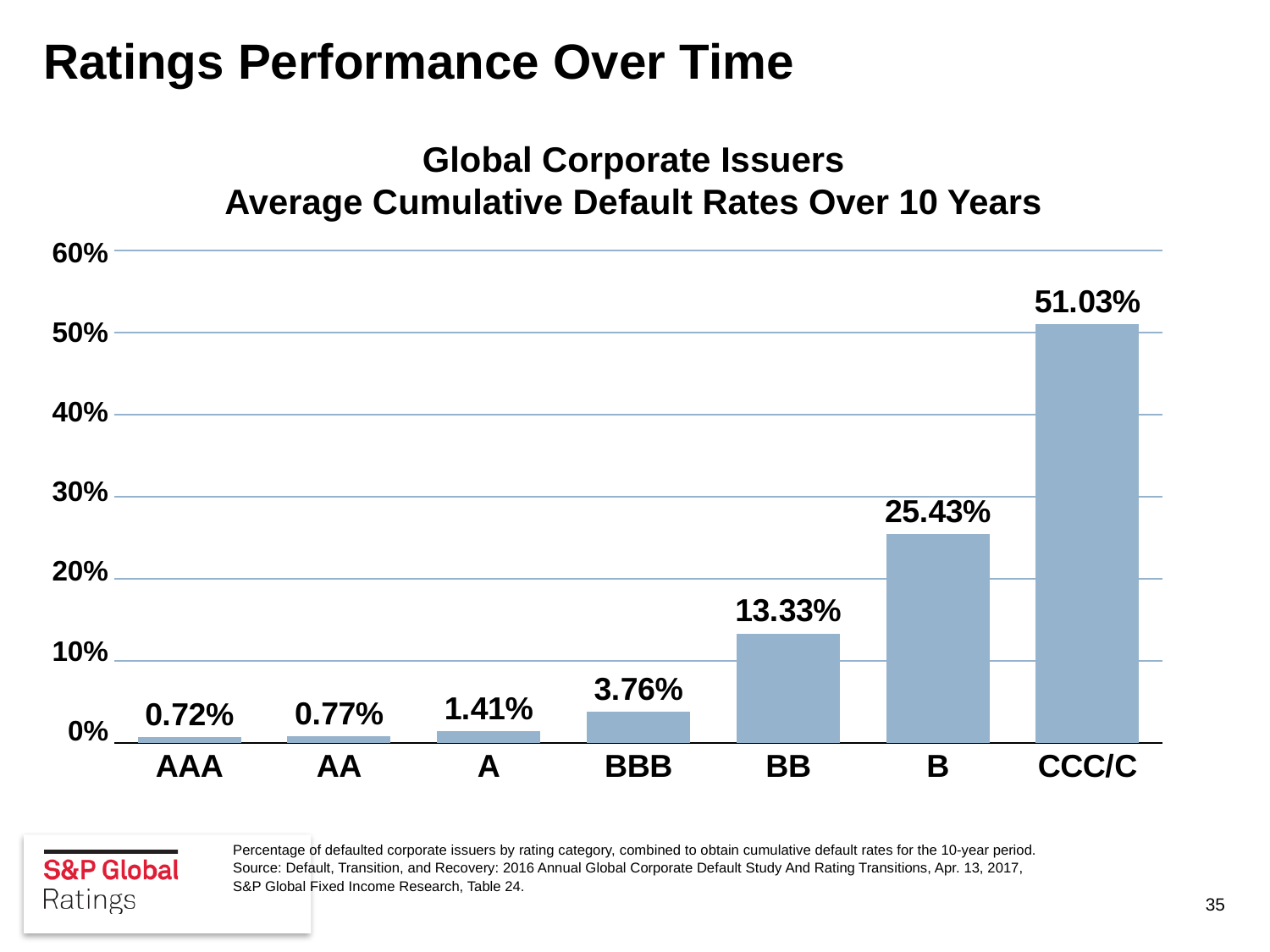
Which has a higher default rate, BB or BBB? BB Is the value for CCC/C greater or less than 50%? greater Which rating category has the highest average cumulative default rate? CCC/C How many rating categories are shown on the x axis? 7 Do the default rates rise or fall moving from AAA to CCC/C along the x axis? Rise Which rating category has the lowest average cumulative default rate? AAA What is the average cumulative default rate over 10 years for the AAA rating category? 0.72% What is the difference between the default rates for BBB and A? 2.35% What is the average cumulative default rate over 10 years for the B rating category? 25.43% What kind of chart is shown on the slide? Bar chart What is the difference between the default rates for CCC/C and B? 25.60% What is the average cumulative default rate over 10 years for the BB rating category? 13.33%